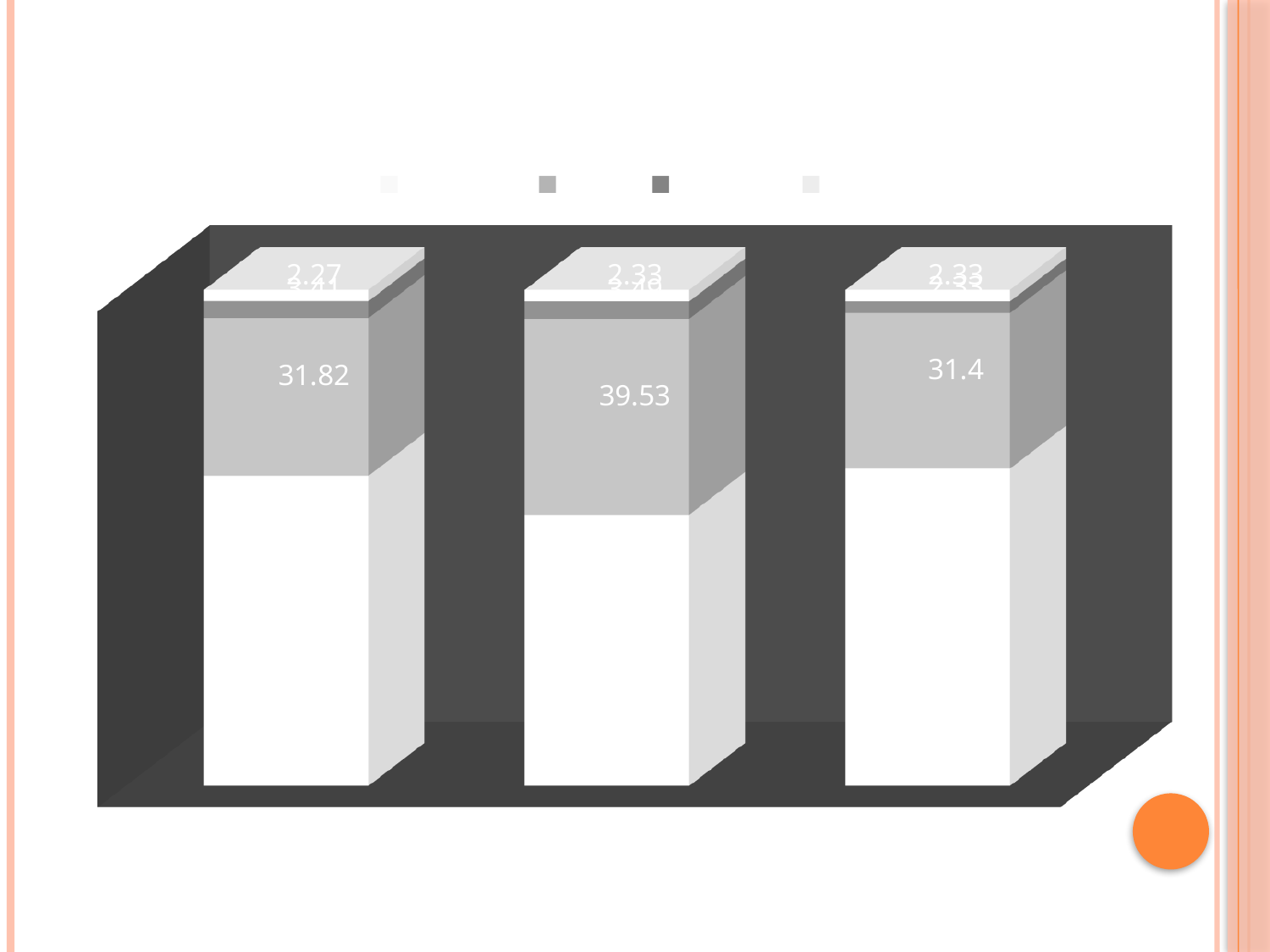
How many series does the legend list? 4 Which is larger, the grey middle segment value of the left bar or of the right bar? the left bar What is the value labelled on the grey middle segment of the left bar? 31.82 How many bars are plotted in the chart? 3 Which bar has the lowest labelled value on its grey middle segment? the right bar What is the value labelled on the grey middle segment of the right bar? 31.4 Which bar has the highest labelled value on its grey middle segment? the middle bar What is the difference between the grey middle segment values of the middle bar and the left bar? 7.71 What kind of chart is shown on the slide? bar chart What is the difference between the grey middle segment values of the middle bar and the right bar? 8.13 Is the chart drawn in 3D or flat 2D style? 3D What is the value labelled on the grey middle segment of the middle bar? 39.53